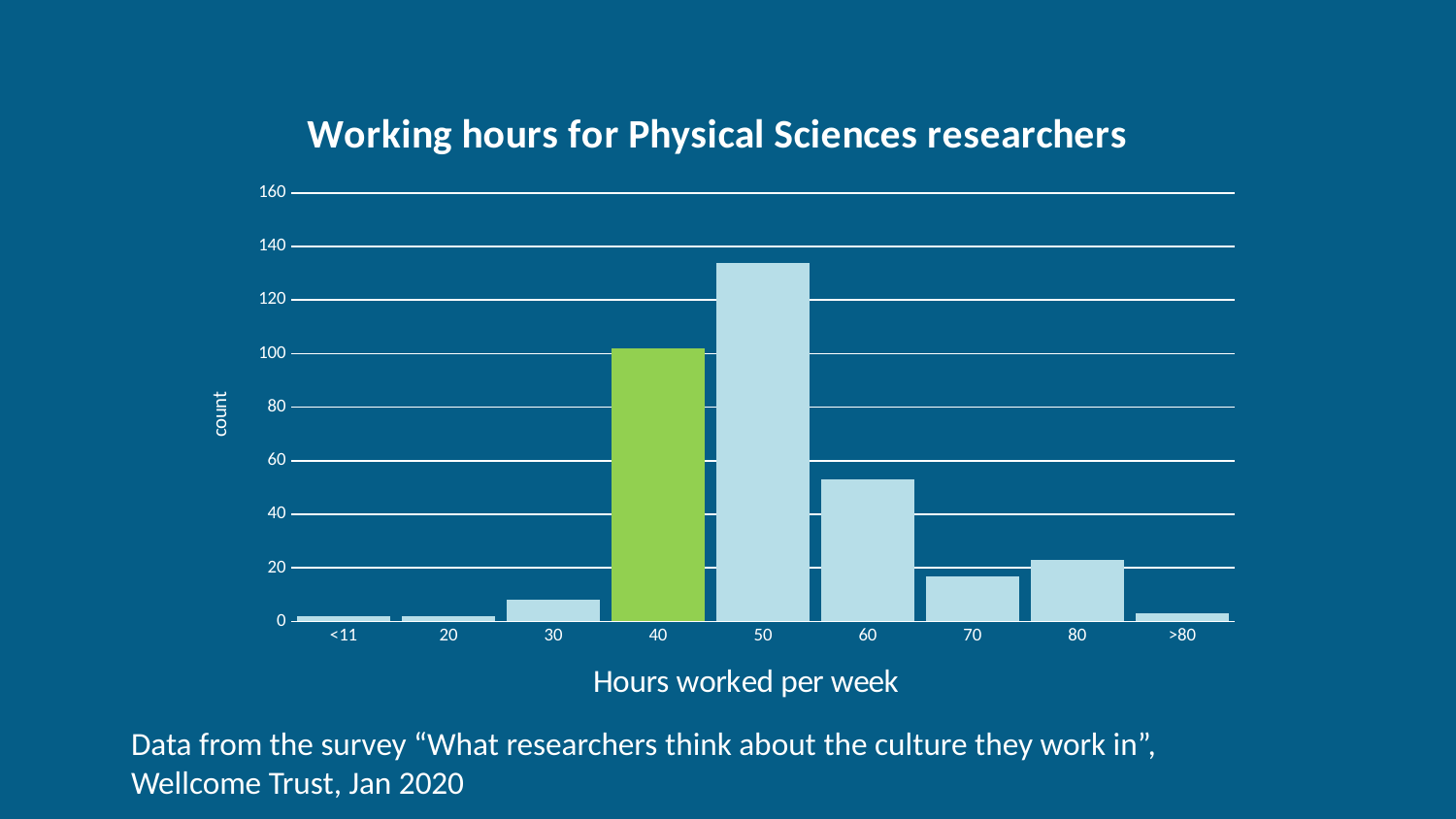
What kind of chart is shown on the slide? bar chart Which hours-worked category is shown with a green bar? 40 How many hours-worked categories are shown on the x axis? 9 Which has a higher count, the 70 hours category or the 80 hours category? 80 What is the title of the chart? Working hours for Physical Sciences researchers Is the count for the 40 hours category greater or less than 80? greater Which has a higher count, the 40 hours category or the 60 hours category? 40 Is the count for the 70 hours category greater or less than 20? less Which hours-worked category has the highest count? 50 Is the count for the 60 hours category greater or less than 40? greater